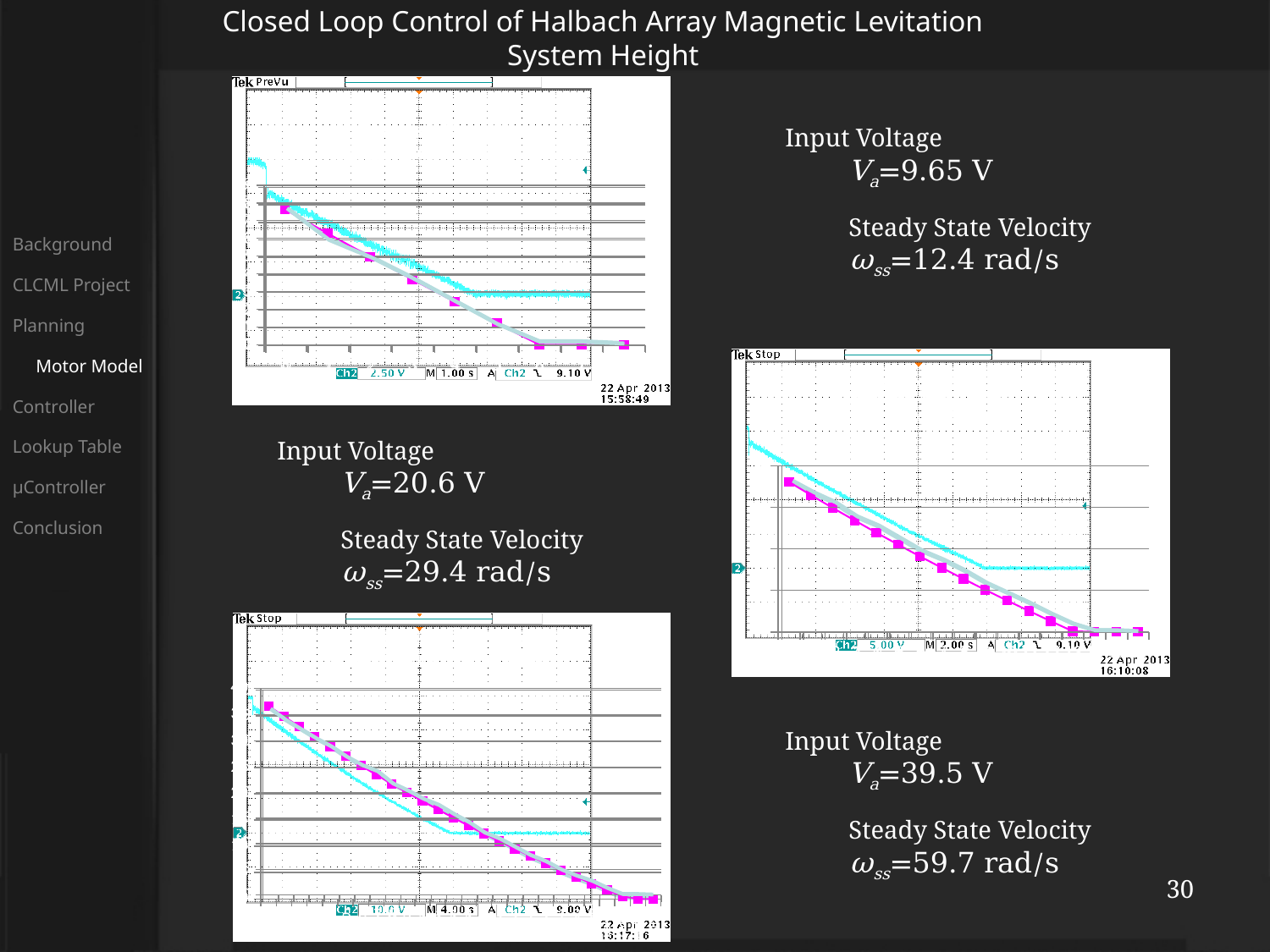
Which listed input voltage gives the highest steady state velocity? 39.5 V What is the difference between the steady state velocities listed for 39.5 V and 9.65 V? 47.3 rad/s In the top-left oscilloscope plot, what time-per-division setting (M) is shown in the status bar? 1.00 s As the listed input voltage increases, does the listed steady state velocity rise or fall? rise How many oscilloscope plots are shown on the slide? 3 What steady state velocity is listed for an input voltage of 20.6 V? 29.4 rad/s What steady state velocity is listed for an input voltage of 39.5 V? 59.7 rad/s In the oscilloscope plot on the right side of the slide, does the magenta trace rise or fall from left to right? fall In the oscilloscope plot on the right side of the slide, what Ch2 volts-per-division setting is shown in the status bar? 5.00 V Which listed input voltage gives the lowest steady state velocity? 9.65 V Is the steady state velocity listed for 20.6 V larger or smaller than that listed for 39.5 V? smaller What steady state velocity is listed for an input voltage of 9.65 V? 12.4 rad/s